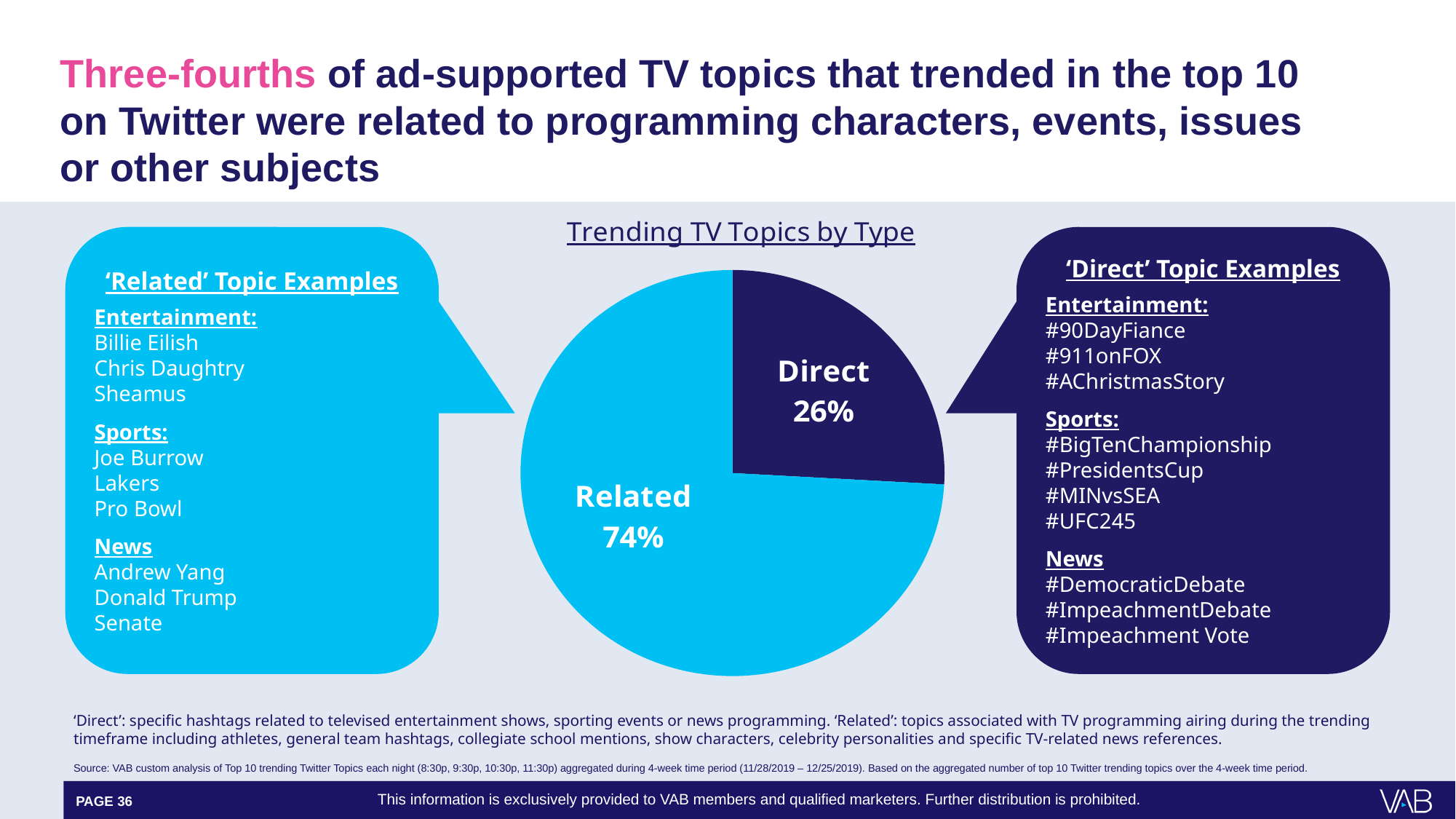
What is the title of the chart? Trending TV Topics by Type What is the combined share of the Related and Direct slices? 100% Which slice of the pie chart is the largest? Related How many slices does the pie chart have? 2 Which slice of the pie chart is the smallest? Direct What share of trending TV topics is labelled Related in the pie chart? 74% What kind of chart is shown on the slide? Pie chart Which is larger, the Related slice or the Direct slice? Related What colour is the Direct slice of the pie chart? Dark navy blue By how many percentage points does the Related share exceed the Direct share? 48 What share of trending TV topics is labelled Direct in the pie chart? 26%